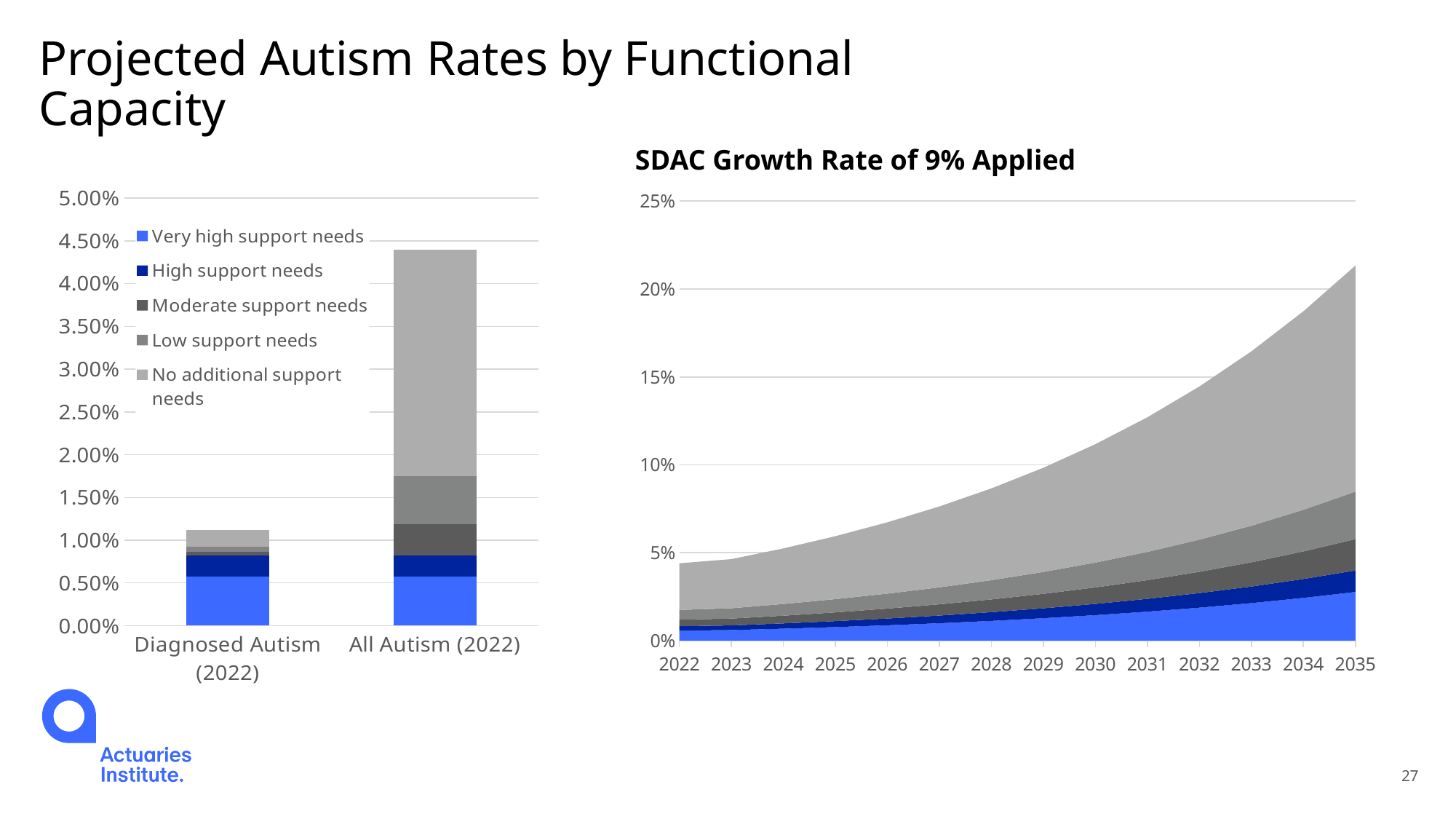
In the left-hand bar chart, which legend entry is shown in the lightest grey colour? No additional support needs In the chart titled 'SDAC Growth Rate of 9% Applied', how many years are shown on the x axis? 14 In the chart titled 'SDAC Growth Rate of 9% Applied', do the stacked values rise or fall from 2022 to 2035? rise In the chart titled 'SDAC Growth Rate of 9% Applied', is the total value in 2035 greater or less than 20%? greater What kind of chart is the left-hand chart on the slide? bar chart In the left-hand bar chart, is the total for Diagnosed Autism (2022) greater or less than 1.50%? less In the left-hand bar chart, is the total for All Autism (2022) greater or less than 4.00%? greater How many series does the legend of the left-hand bar chart list? 5 In the left-hand bar chart, which category has the taller stacked bar, Diagnosed Autism (2022) or All Autism (2022)? All Autism (2022) What is the title of the right-hand chart? SDAC Growth Rate of 9% Applied In the chart titled 'SDAC Growth Rate of 9% Applied', which year has the highest total value? 2035 How many categories does the left-hand bar chart show? 2